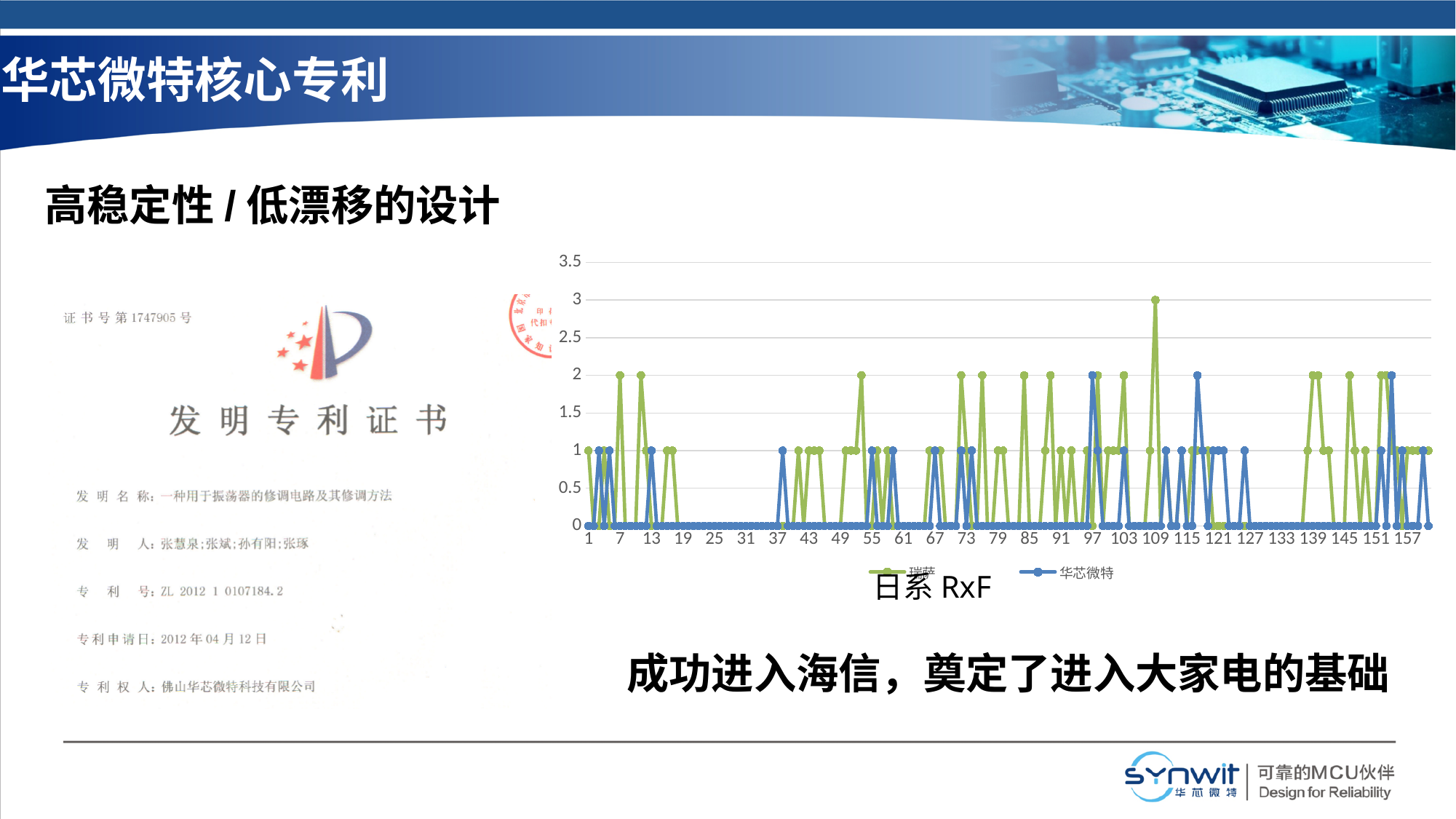
What is the last label shown on the chart's x axis? 157 Which series reaches the higher peak value, the green series or the blue 华芯微特 series? the green series What is the highest value reached by the green series in the chart? 3 Is the peak value of the 华芯微特 series greater or less than 2.5? less How many series does the chart's legend list? 2 What kind of chart is shown on the slide? line chart Is the peak value of the green series greater or less than 2.5? greater What is the lowest value plotted for either series in the chart? 0 What is the highest value reached by the 华芯微特 (blue) series in the chart? 2 What is the highest tick value shown on the chart's y axis? 3.5